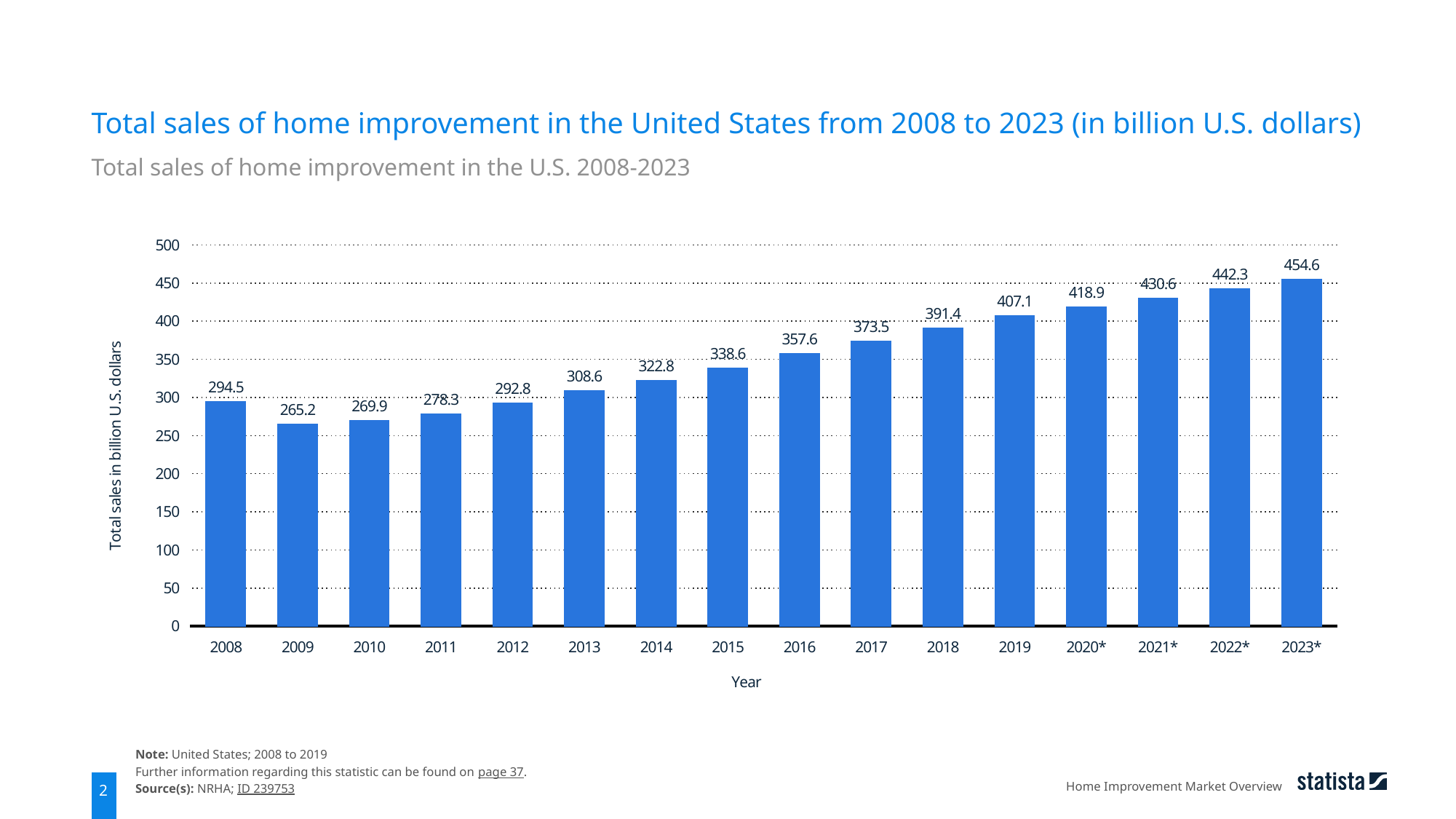
What is the value shown for 2023*? 454.6 What is the total sales of home improvement in the United States in 2008? 294.5 What kind of chart is shown on the slide? bar chart What is the label of the y axis? Total sales in billion U.S. dollars What is the difference between the values for 2019 and 2018? 15.7 What is the value shown for 2015? 338.6 Which is larger, the value for 2008 or the value for 2012? 2008 Do the values generally rise or fall from 2009 to 2023*? rise How many years are shown on the x axis? 16 Is the value for 2017 greater or less than 350? greater Which year has the lowest total sales of home improvement? 2009 Which year has the highest total sales of home improvement? 2023*